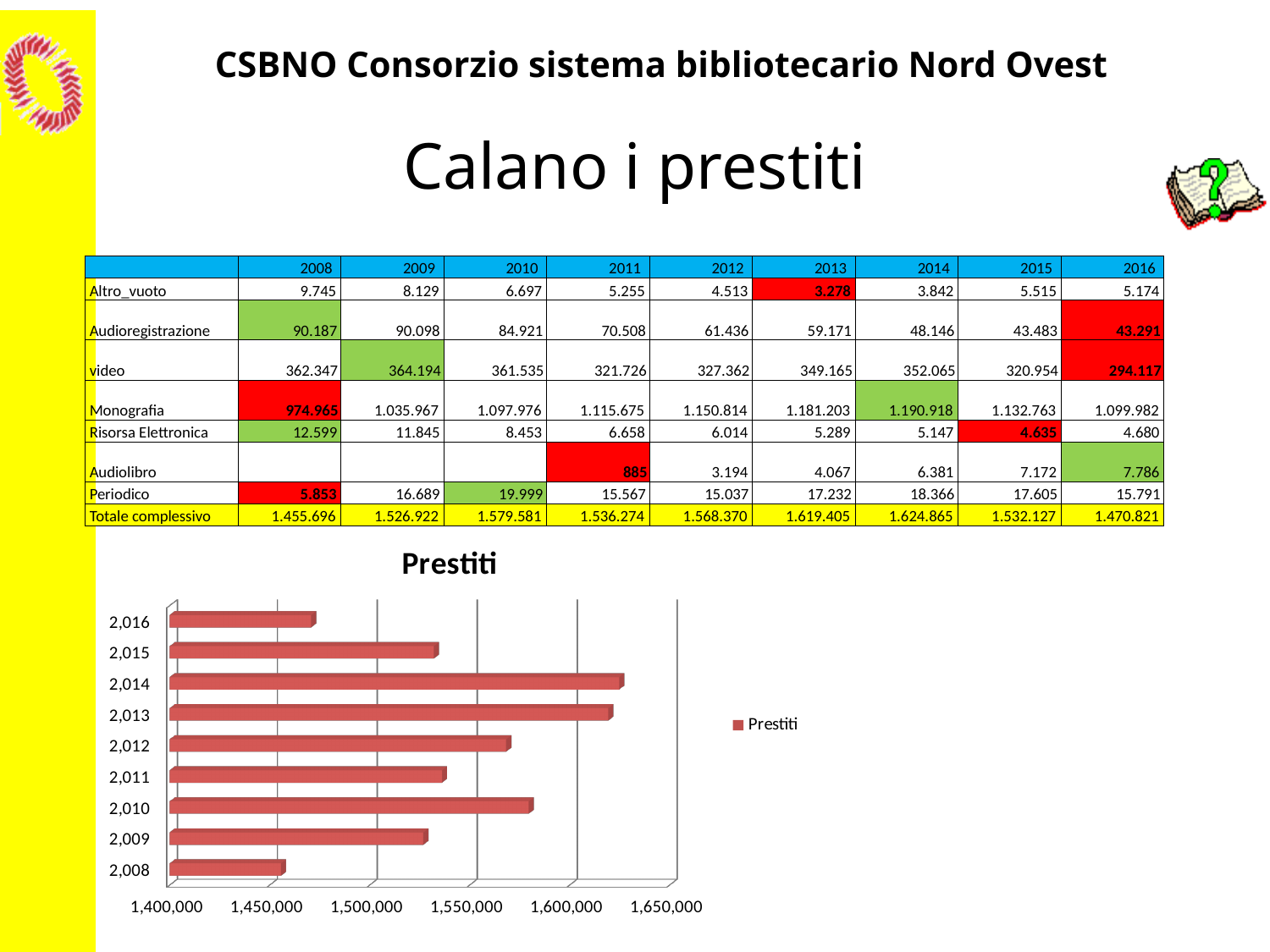
Is the value for 2,010 greater or less than 1,550,000? greater Which is larger, the value for 2,015 or the value for 2,016? 2,015 Do the values rise or fall from 2,014 to 2,016? fall Which year has the lowest value in the chart? 2,008 Which is larger, the value for 2,010 or the value for 2,011? 2,010 How many series does the chart legend list? 1 Is the value for 2,016 greater or less than 1,500,000? less How many years are plotted in the chart? 9 Is the value for 2,013 greater or less than 1,600,000? greater What is the title of the chart? Prestiti What kind of chart is shown on the slide? bar chart